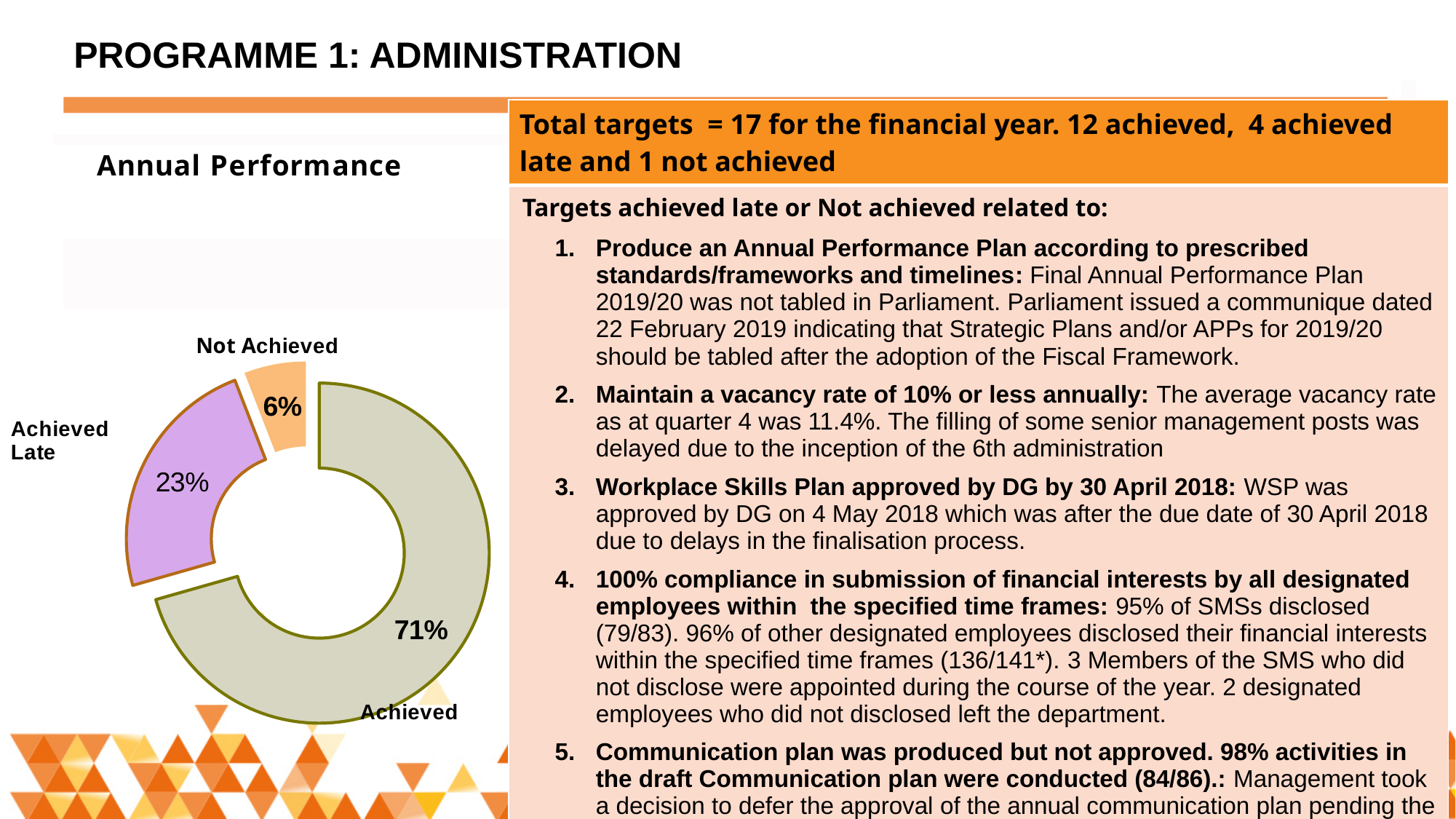
What percentage of targets were Not Achieved according to the chart? 6% What is the title of the chart? Annual Performance What percentage of targets were Achieved according to the chart? 71% How many categories are shown in the chart? 3 What kind of chart is shown under the heading 'Annual Performance'? Doughnut (pie) chart What colour is the Achieved Late slice of the chart? Purple What is the difference in percentage points between Achieved Late and Not Achieved? 17 Which is larger, the share for Achieved Late or the share for Not Achieved? Achieved Late Which category has the smallest share of the chart? Not Achieved What is the difference in percentage points between Achieved and Achieved Late? 48 What percentage of targets were Achieved Late according to the chart? 23% Which category has the largest share of the chart? Achieved